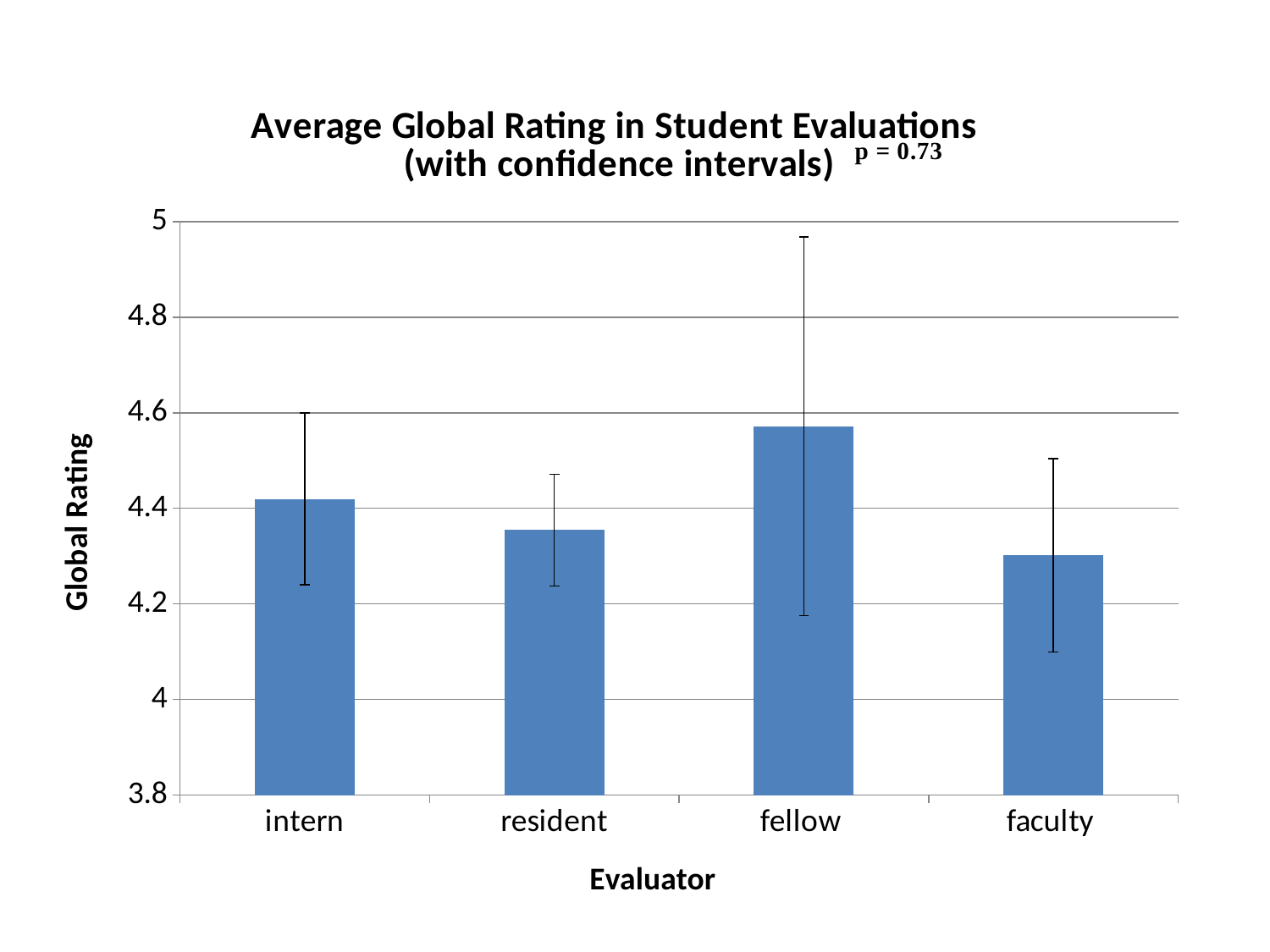
What kind of chart is shown on the slide? bar chart Which has a higher average global rating, intern or resident? intern Which evaluator has the highest average global rating? fellow What p value is printed next to the chart title? p = 0.73 Is the value for resident greater or less than 4.4? less How many evaluator categories are shown on the x axis? 4 Which has a higher average global rating, fellow or faculty? fellow Is the value for fellow greater or less than 4.4? greater Is the value for faculty greater or less than 4.2? greater Which evaluator has the lowest average global rating? faculty What is the title of the y axis? Global Rating